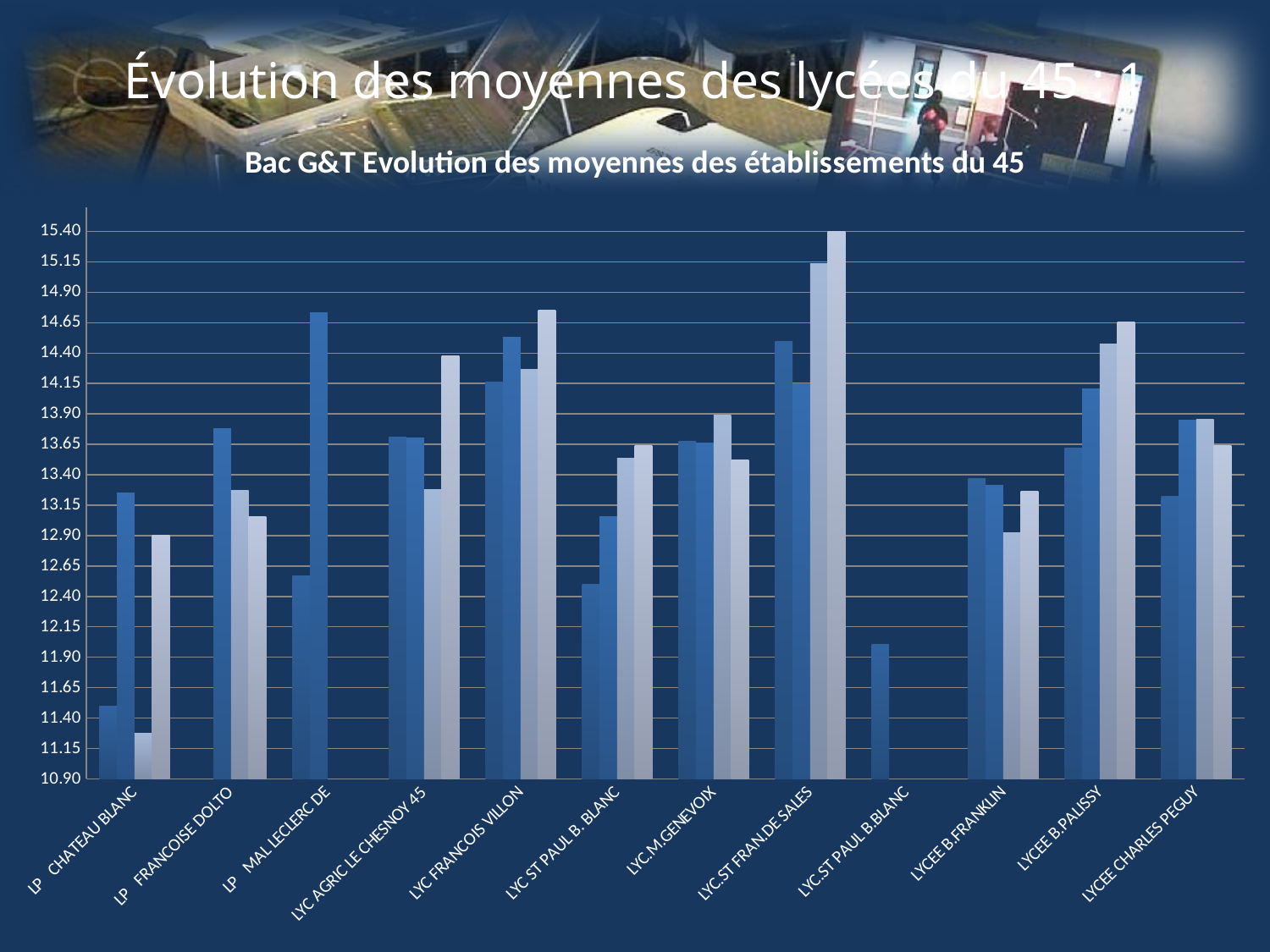
Which establishment has the tallest bar in the chart? LYC.ST FRAN.DE SALES How many bars are plotted for LYC.ST PAUL B.BLANC? 1 How many establishments (categories) are shown on the x axis of the chart? 12 Which has a taller highest bar: LYC.ST FRAN.DE SALES or LYCEE B.PALISSY? LYC.ST FRAN.DE SALES Is the tallest bar for LP MAL LECLERC DE greater or less than 14.40? greater Is the single bar for LYC.ST PAUL B.BLANC greater or less than 12.40? less What is the title of the chart? Bac G&T Evolution des moyennes des établissements du 45 Which establishment has the lowest bar in the chart? LP CHATEAU BLANC What kind of chart is shown on the slide? bar chart Is the tallest bar for LYC.ST FRAN.DE SALES greater or less than 15.15? greater What is the highest value shown on the vertical axis of the chart? 15.40